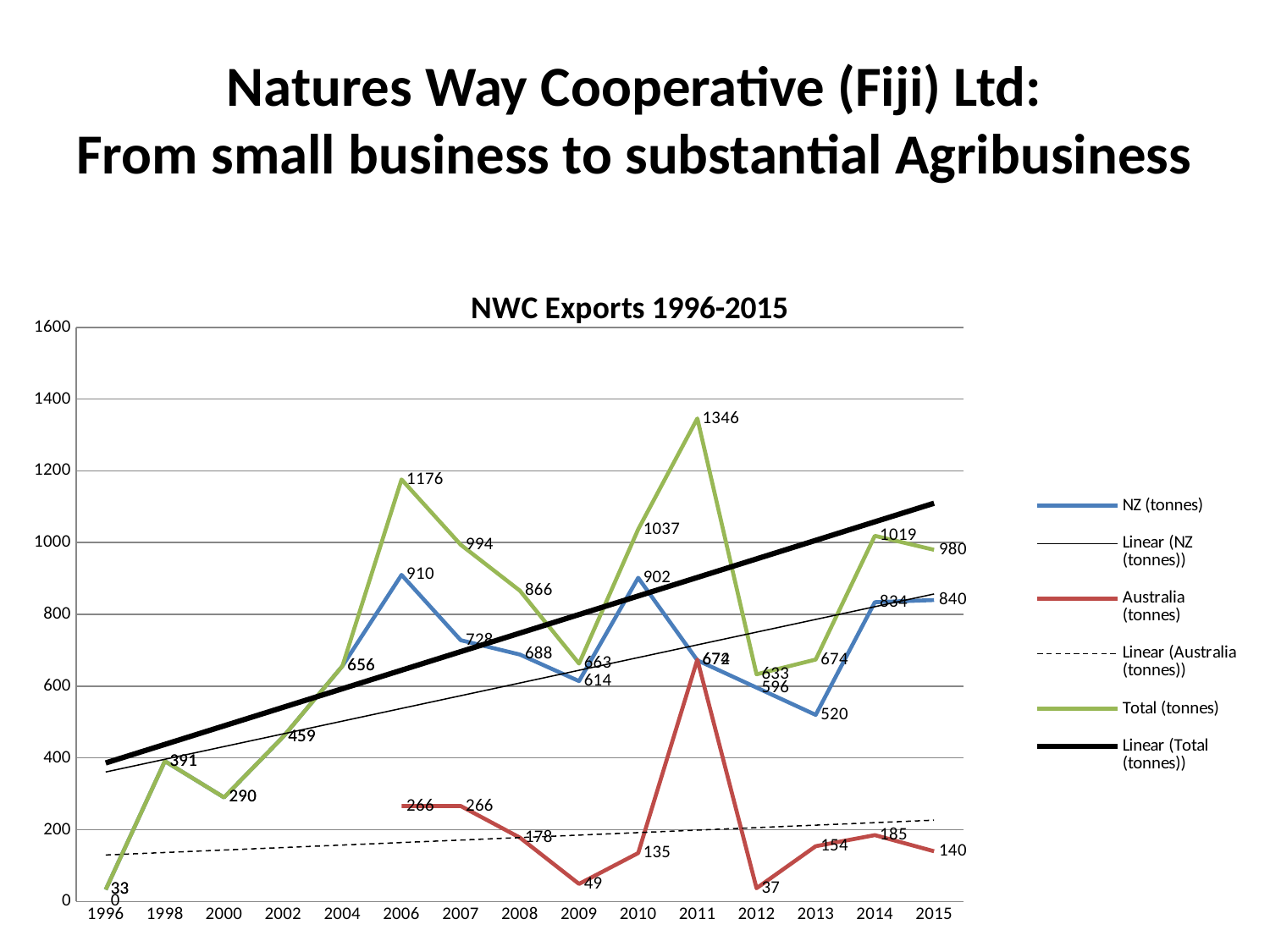
In which year is Total (tonnes) highest? 2011 What kind of chart is shown on the slide? Line chart What is the value of Australia (tonnes) in 2012? 37 How many series does the legend list? 6 Does the Linear (Total (tonnes)) trend line rise or fall from 1996 to 2015? Rise What is the value of NZ (tonnes) in 2015? 840 In which year is Total (tonnes) lowest? 1996 Which is larger, NZ (tonnes) in 2013 or in 2014? 2014 What is the value of Total (tonnes) in 2006? 1176 What is the title of the chart? NWC Exports 1996-2015 What is the difference between Total (tonnes) in 2014 and in 2015? 39 How many years are shown on the x axis? 15